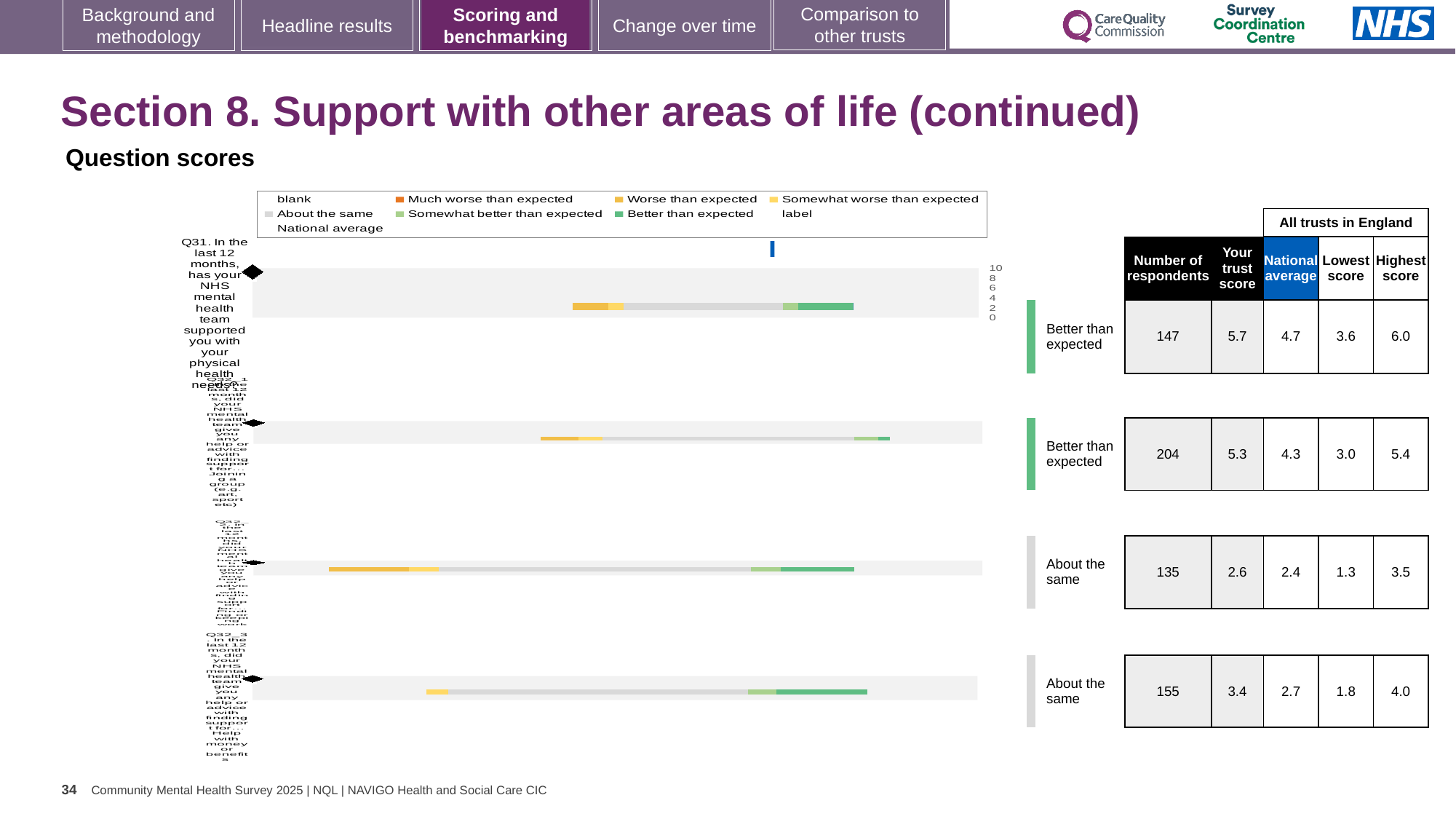
How many of the four questions are labelled 'About the same'? 2 What benchmark label is shown for Q31? Better than expected What kind of chart is shown on the slide? bar chart For Q31, which is larger: the trust score or the national average? the trust score What is the lowest score shown for the bottom question in the table? 1.8 What is the highest score across all trusts in England for Q31? 6.0 How many question bars are plotted in the chart? 4 Which question has the highest 'Your trust score' in the table? Q31 What is the difference between the trust score and the national average for Q31? 1.0 What is the 'Your trust score' for Q31 in the table next to the chart? 5.7 How many respondents are listed for Q31? 147 How many entries does the chart legend list? 9